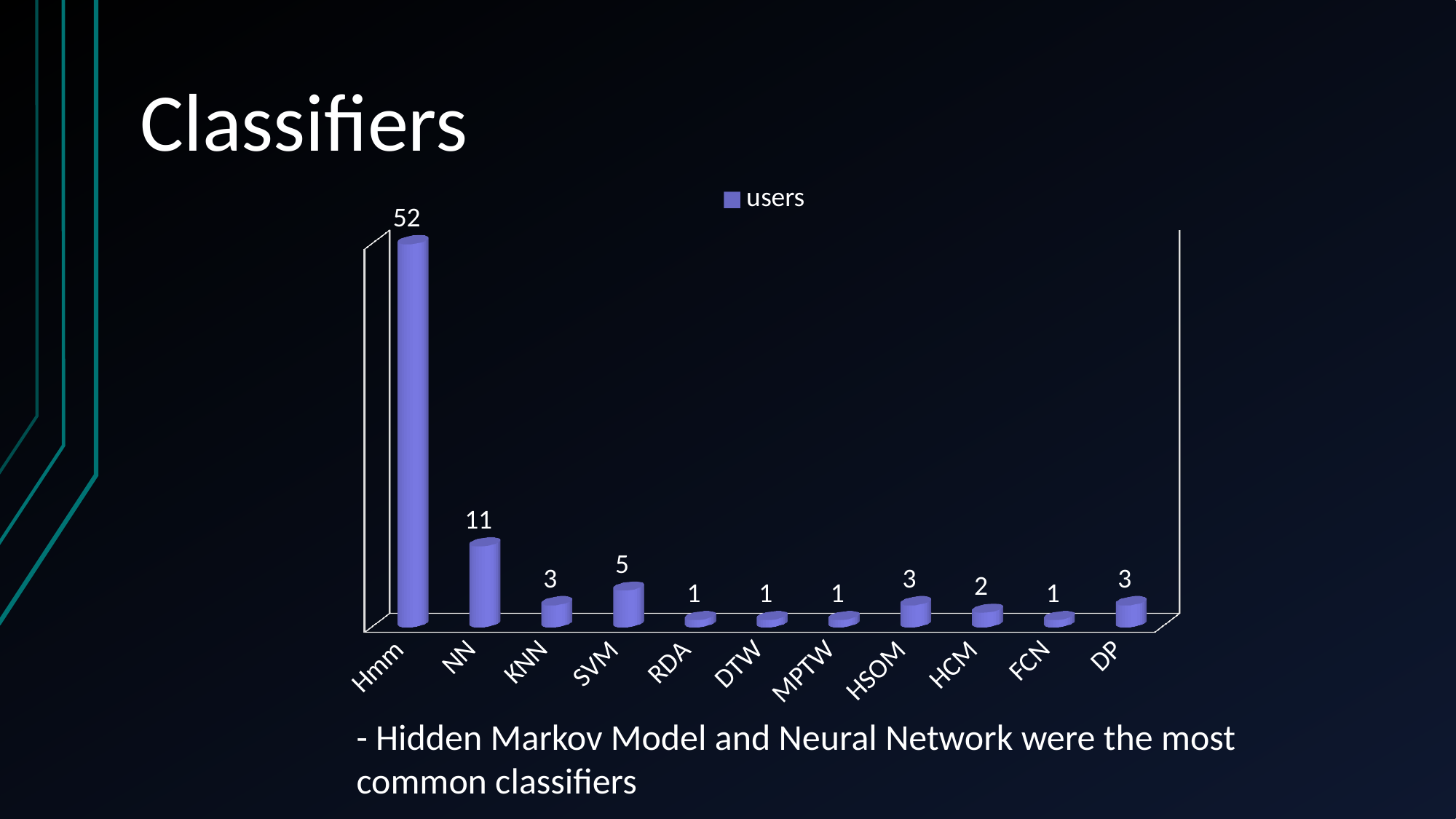
What is the name of the series shown in the legend? users What is the value for NN? 11 What is the value for HCM? 2 Which is larger, the value for SVM or the value for HSOM? SVM How many series does the legend list? 1 What kind of chart is shown on the slide? bar chart What is the value for SVM? 5 What is the difference between the values for SVM and KNN? 2 What is the value for Hmm? 52 What is the difference between the values for Hmm and NN? 41 How many categories are shown on the x axis? 11 Which category has the highest value? Hmm